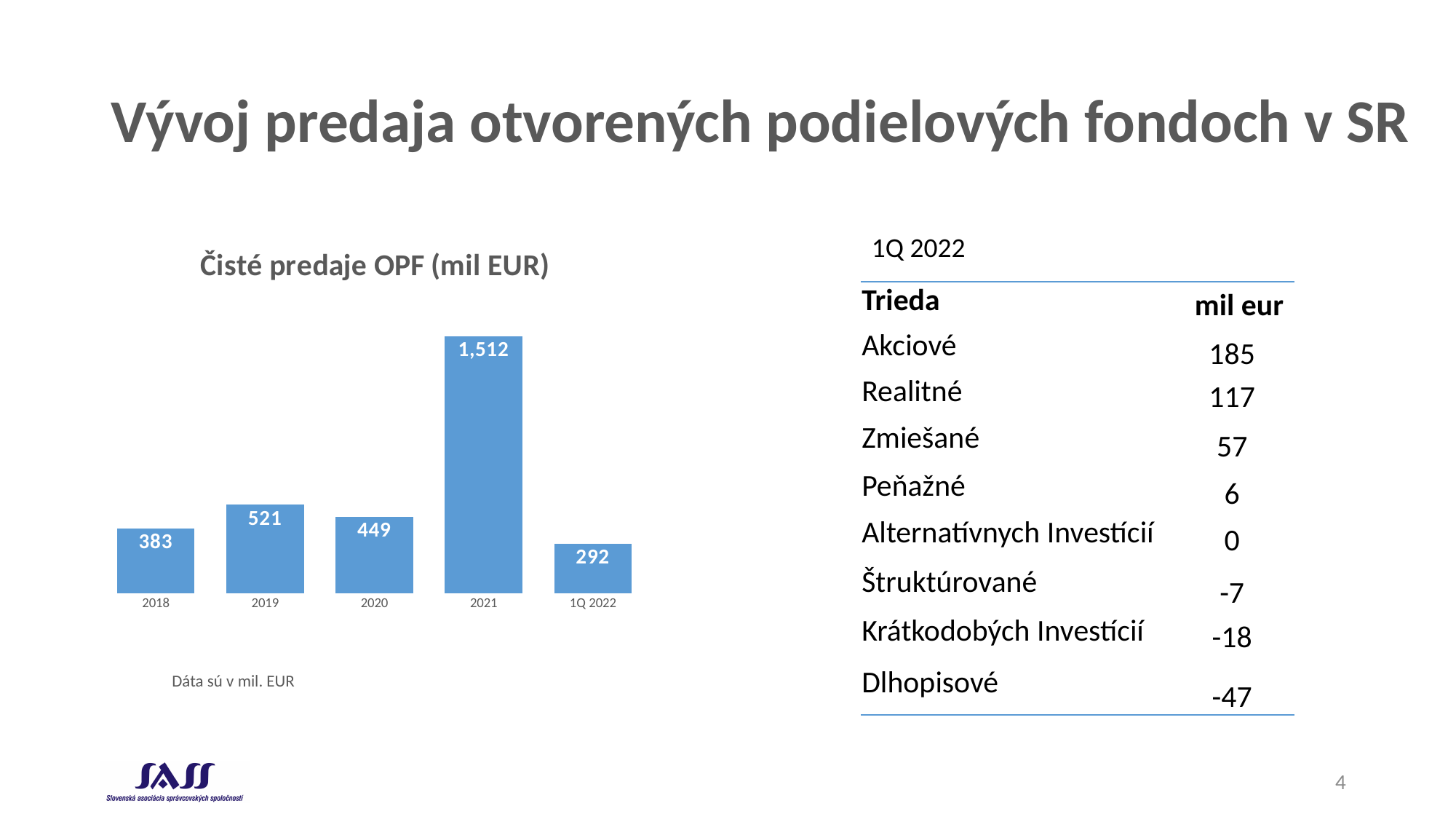
What is the difference between the values for 2021 and 2018 in the chart 'Čisté predaje OPF (mil EUR)'? 1,129 Which is larger in the chart 'Čisté predaje OPF (mil EUR)', the value for 2019 or the value for 2020? 2019 What is the difference between the values for 2019 and 2020 in the chart 'Čisté predaje OPF (mil EUR)'? 72 What is the value for 2018 in the chart 'Čisté predaje OPF (mil EUR)'? 383 What kind of chart is 'Čisté predaje OPF (mil EUR)'? bar chart Which category has the lowest value in the chart 'Čisté predaje OPF (mil EUR)'? 1Q 2022 Which category has the highest value in the chart 'Čisté predaje OPF (mil EUR)'? 2021 What is the value for 1Q 2022 in the chart 'Čisté predaje OPF (mil EUR)'? 292 In the chart 'Čisté predaje OPF (mil EUR)', does the value rise or fall from 2020 to 2021? rise What is the value for 2021 in the chart 'Čisté predaje OPF (mil EUR)'? 1,512 How many categories are shown on the x axis of the chart 'Čisté predaje OPF (mil EUR)'? 5 What is the title of the bar chart on the slide? Čisté predaje OPF (mil EUR)